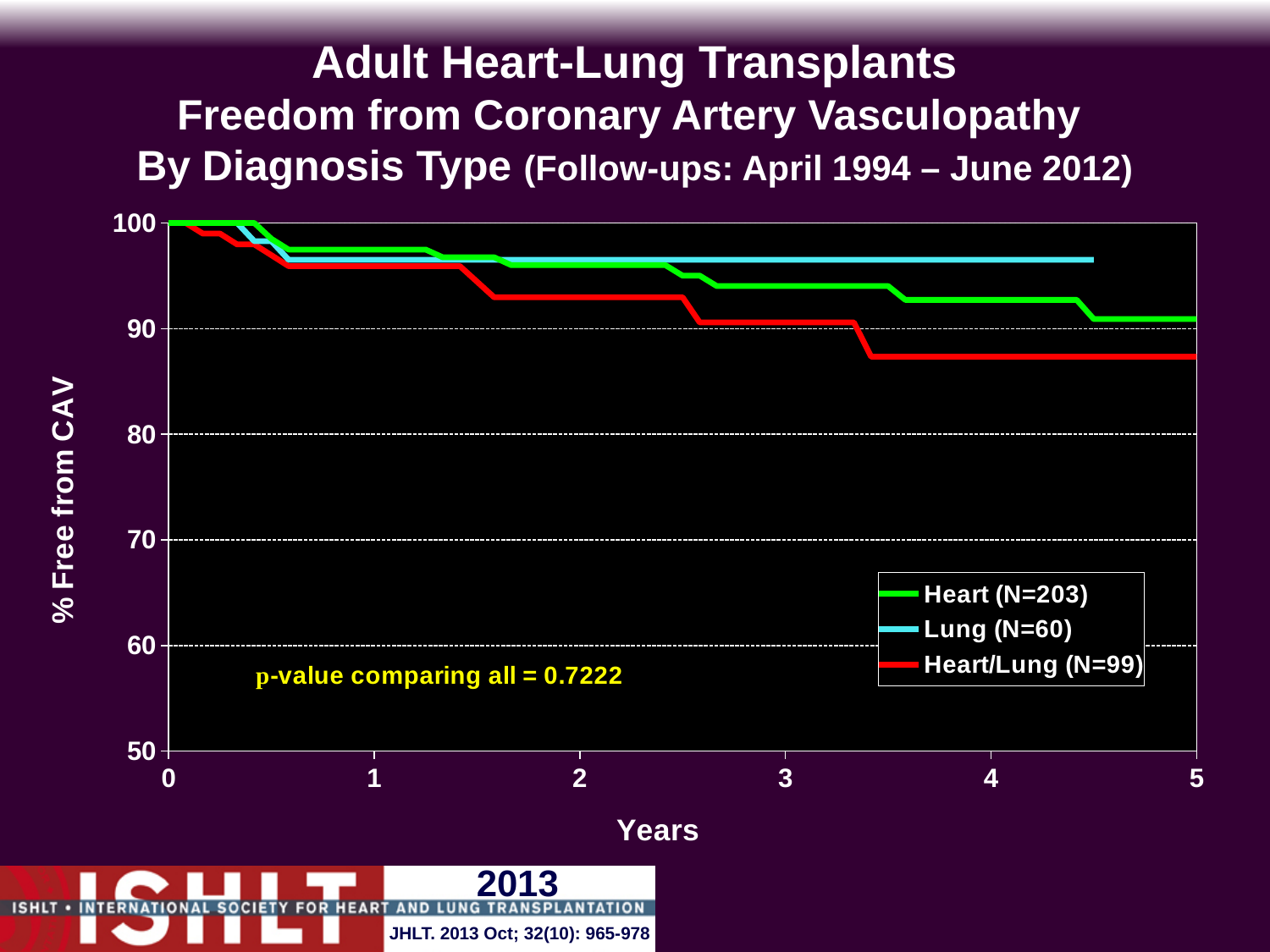
Is the value for Heart (N=203) at 3 years greater or less than 90? greater How many series does the legend list? 3 What p-value comparing all groups is shown on the chart? 0.7222 What is the N for the Heart series in the legend? 203 At 4 years, which is higher: Lung (N=60) or Heart/Lung (N=99)? Lung (N=60) Do the values for Heart/Lung (N=99) rise or fall as years increase? fall Which series has the lowest % free from CAV at 5 years? Heart/Lung (N=99) Which series has the highest % free from CAV at 4 years? Lung (N=60) What kind of chart is shown on the slide? line chart Is the value for Heart/Lung (N=99) at 4 years greater or less than 80? greater Is the value for Lung (N=60) at 4 years greater or less than 90? greater